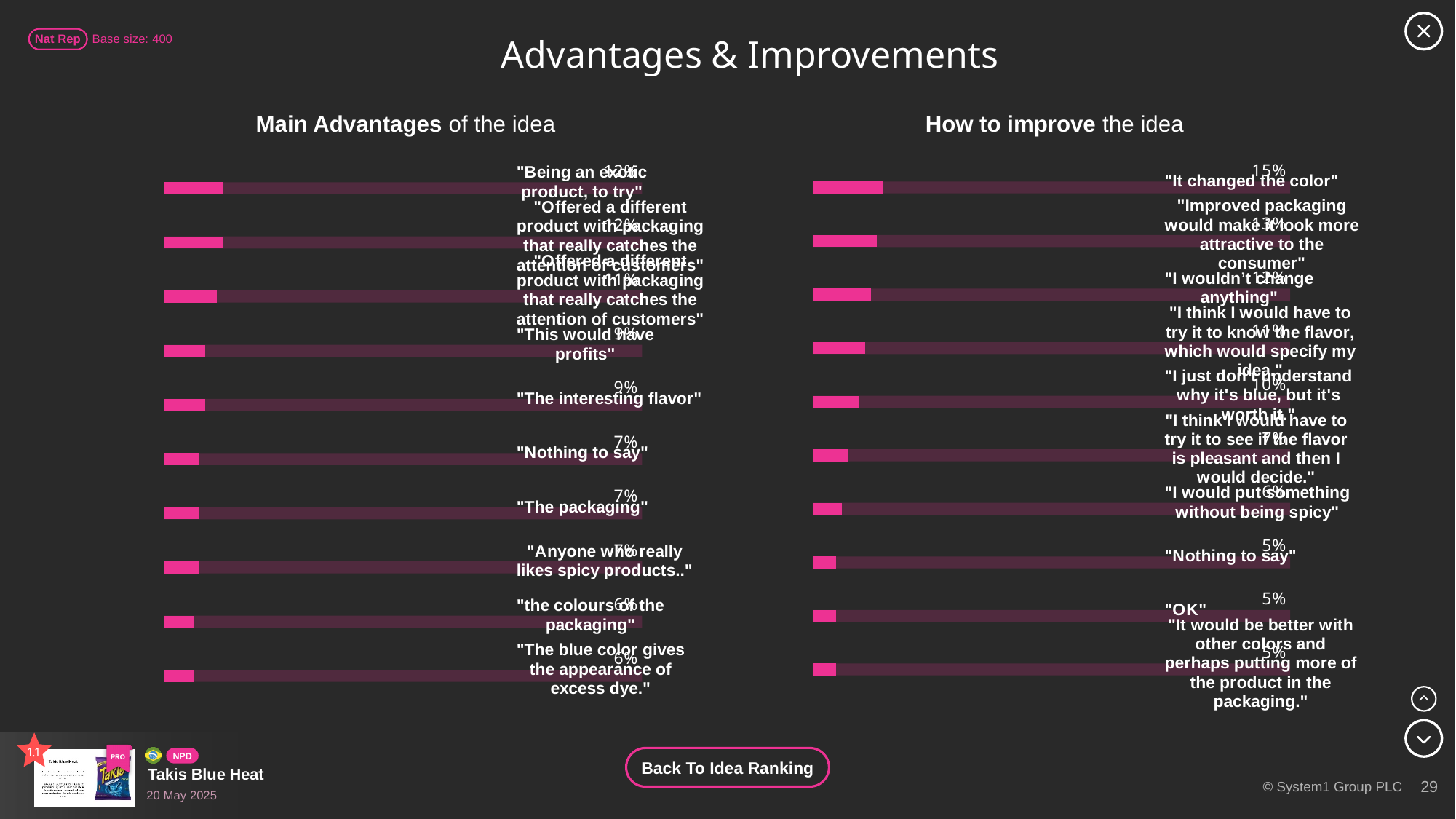
In the "Main Advantages of the idea" chart, what is the value for "Being an exotic product, to try"? 12% In the "How to improve the idea" chart, which category has the highest value? "It changed the color" How many categories are shown in the "Main Advantages of the idea" chart? 10 In the "How to improve the idea" chart, what is the difference between "It changed the color" and "Nothing to say"? 10% In the "How to improve the idea" chart, which is larger: "I wouldn't change anything" or "I just don't understand why it's blue, but it's worth it."? "I wouldn't change anything" What type of chart is the "How to improve the idea" chart? Bar chart In the "How to improve the idea" chart, what is the value for "I wouldn't change anything"? 12% In the "Main Advantages of the idea" chart, what is the difference between "Being an exotic product, to try" and "The packaging"? 5% In the "How to improve the idea" chart, what is the value for "I would put something without being spicy"? 6% In the "How to improve the idea" chart, what is the value for "It changed the color"? 15% In the "Main Advantages of the idea" chart, what is the value for "The interesting flavor"? 9% How many categories are shown in the "How to improve the idea" chart? 10